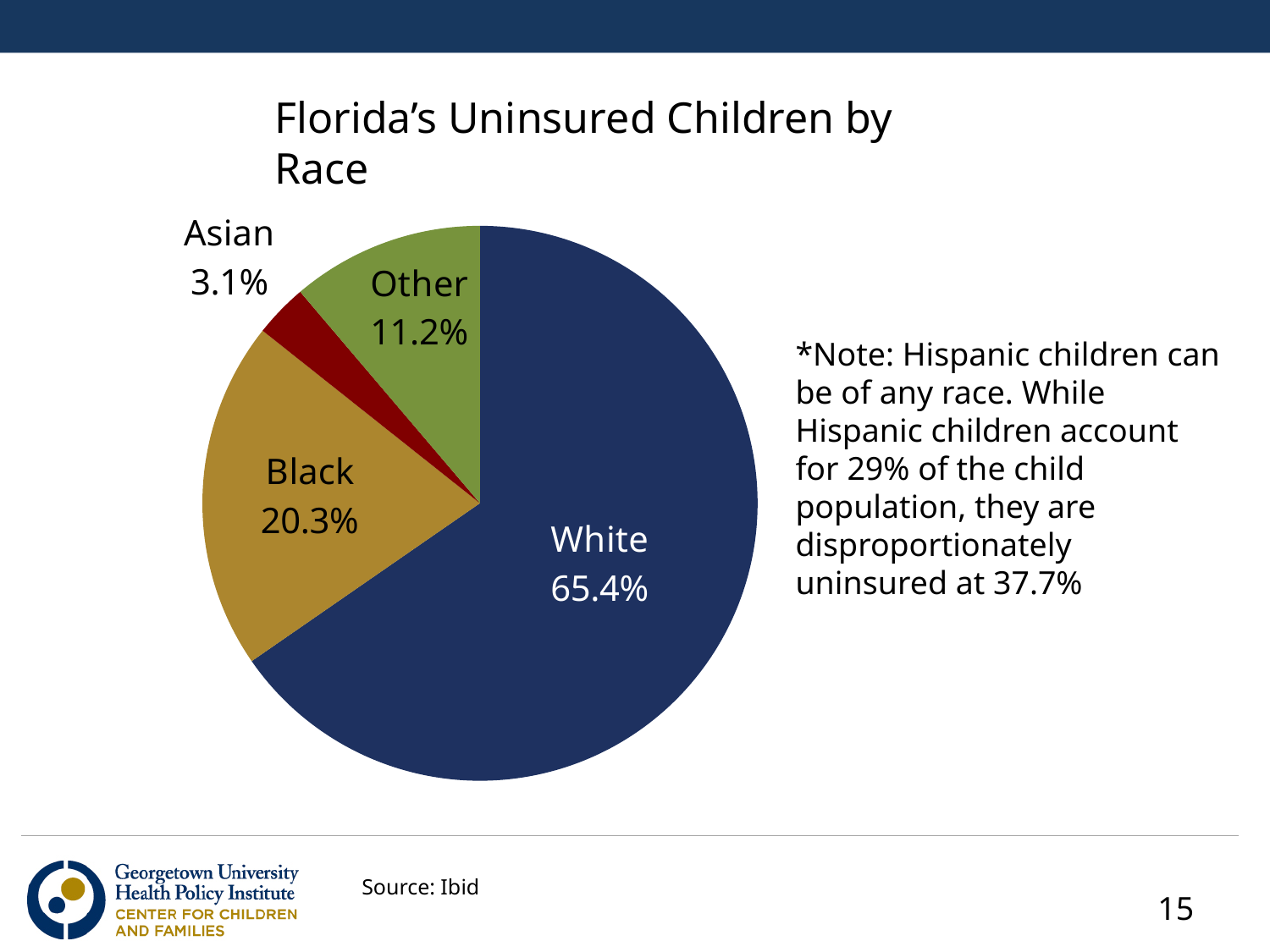
Which race has the smallest share of Florida's uninsured children? Asian How many race categories are shown in the pie chart? 4 What share of Florida's uninsured children fall in the Other category? 11.2% What is the difference in percentage points between the White and Black shares? 45.1 What share of Florida's uninsured children are Asian? 3.1% Which race has the largest share of Florida's uninsured children? White What colour is the slice for Black? Gold What share of Florida's uninsured children are Black? 20.3% What share of Florida's uninsured children are White? 65.4% Which is larger, the Black share or the Other share? Black What kind of chart is shown on the slide? Pie chart What is the title of the chart? Florida's Uninsured Children by Race